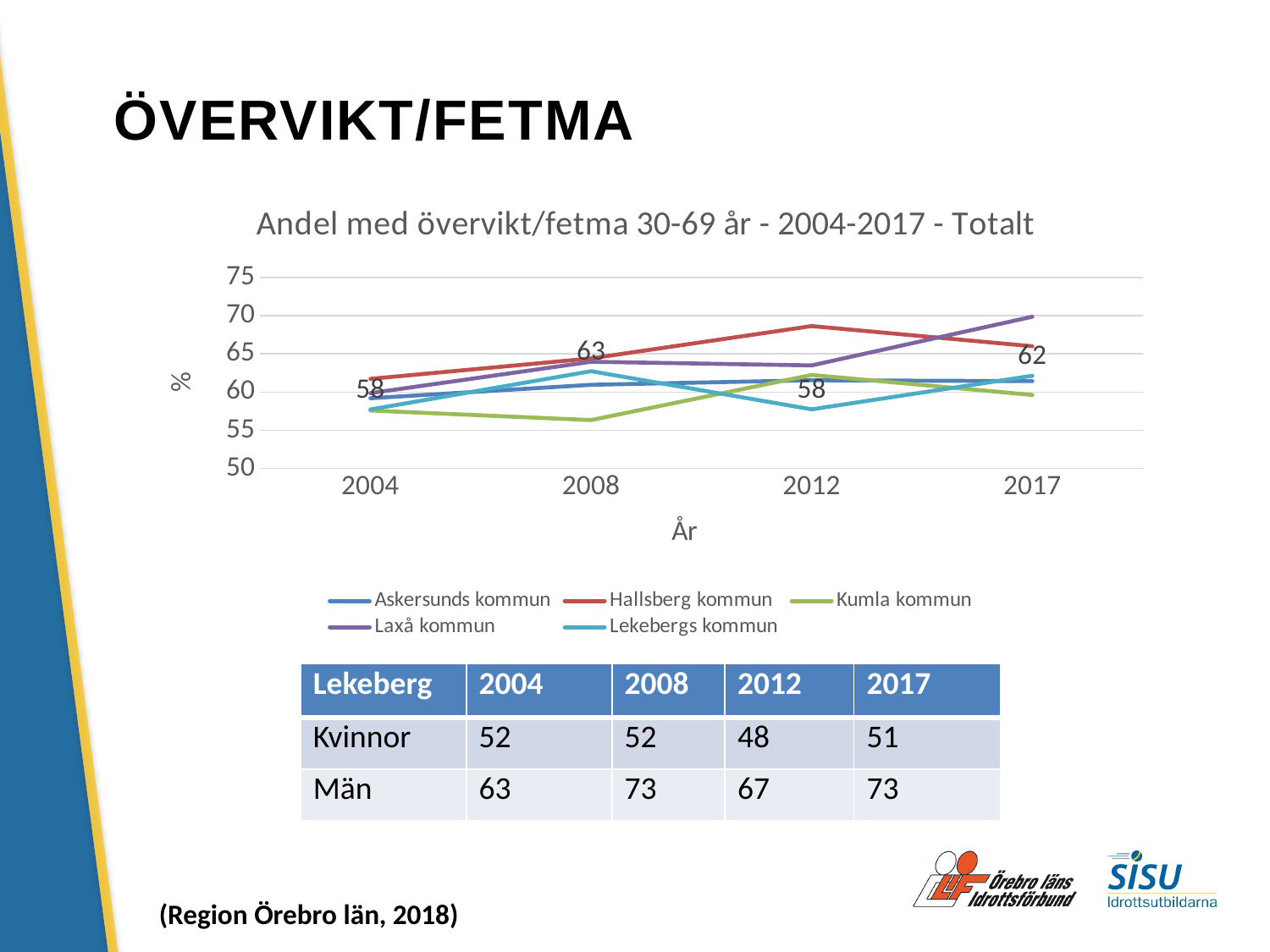
Which municipality has the lowest value in 2008? Kumla kommun What is the difference between the labelled values for Lekebergs kommun in 2008 and 2012? 5 Is the value for Hallsberg kommun in 2012 greater or less than 65? greater Which is larger in 2008, the value for Hallsberg kommun or Kumla kommun? Hallsberg kommun Which municipality has the highest value in 2017? Laxå kommun What is the title of the chart? Andel med övervikt/fetma 30-69 år - 2004-2017 - Totalt What is the labelled value for Lekebergs kommun in 2012? 58 What kind of chart is shown on the slide? line chart What is the labelled value for Lekebergs kommun in 2008? 63 How many years are shown on the x axis of the chart? 4 What is the labelled value for Lekebergs kommun in 2017? 62 How many series does the chart legend list? 5